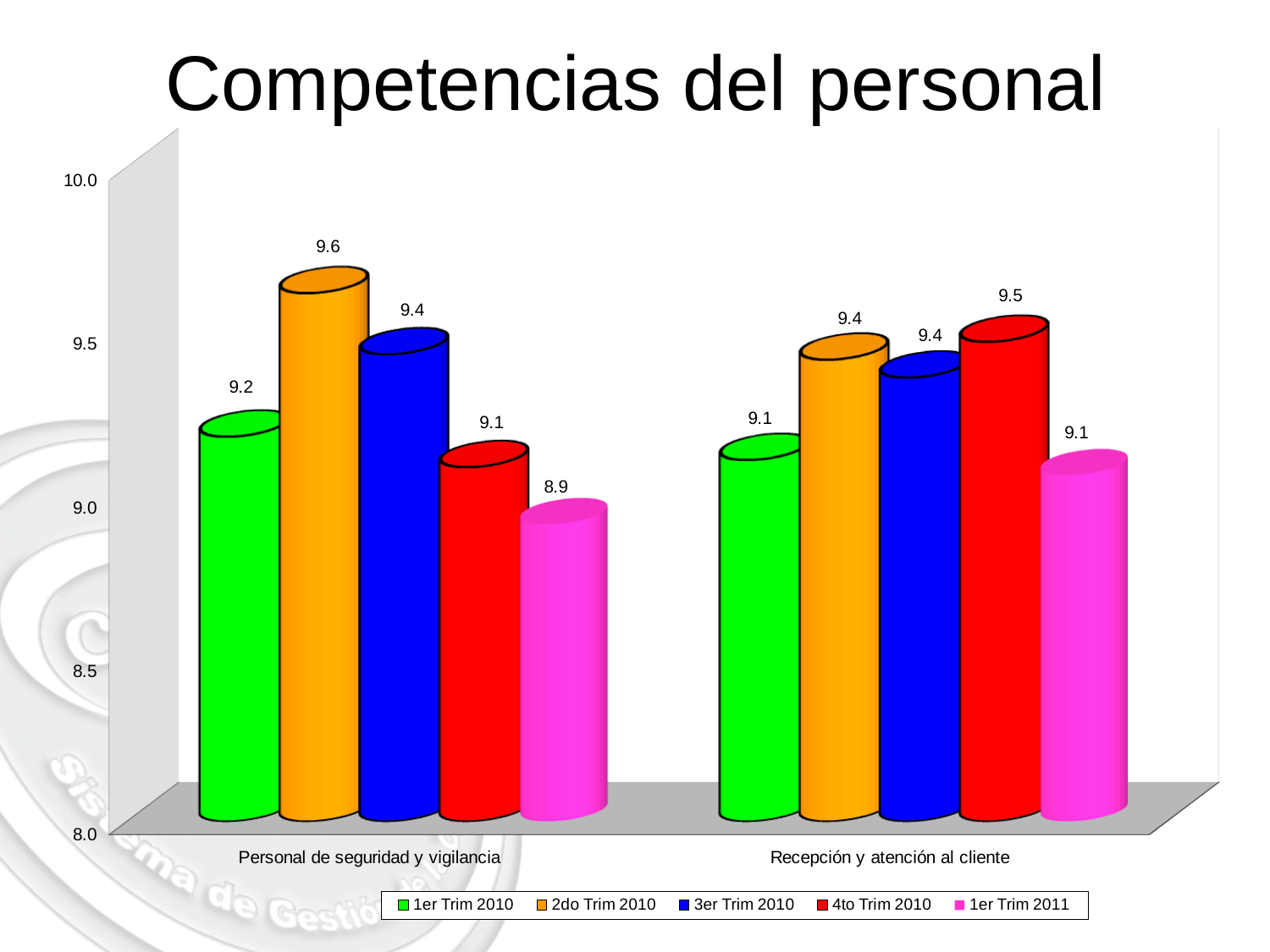
How many series does the legend list? 5 Which is larger: the 1er Trim 2010 value for Personal de seguridad y vigilancia or the 1er Trim 2010 value for Recepción y atención al cliente? Personal de seguridad y vigilancia What is the title of the chart? Competencias del personal What is the difference between the 2do Trim 2010 and 1er Trim 2011 values in the Personal de seguridad y vigilancia category? 0.7 What is the value for 4to Trim 2010 in the Recepción y atención al cliente category? 9.5 What is the value for 2do Trim 2010 in the Personal de seguridad y vigilancia category? 9.6 What kind of chart is shown on the slide? Bar chart How many categories are shown on the x axis? 2 Which series has the lowest value in the Personal de seguridad y vigilancia category? 1er Trim 2011 Which series has the highest value in the Personal de seguridad y vigilancia category? 2do Trim 2010 What is the value for 1er Trim 2011 in the Recepción y atención al cliente category? 9.1 Which series has the highest value in the Recepción y atención al cliente category? 4to Trim 2010